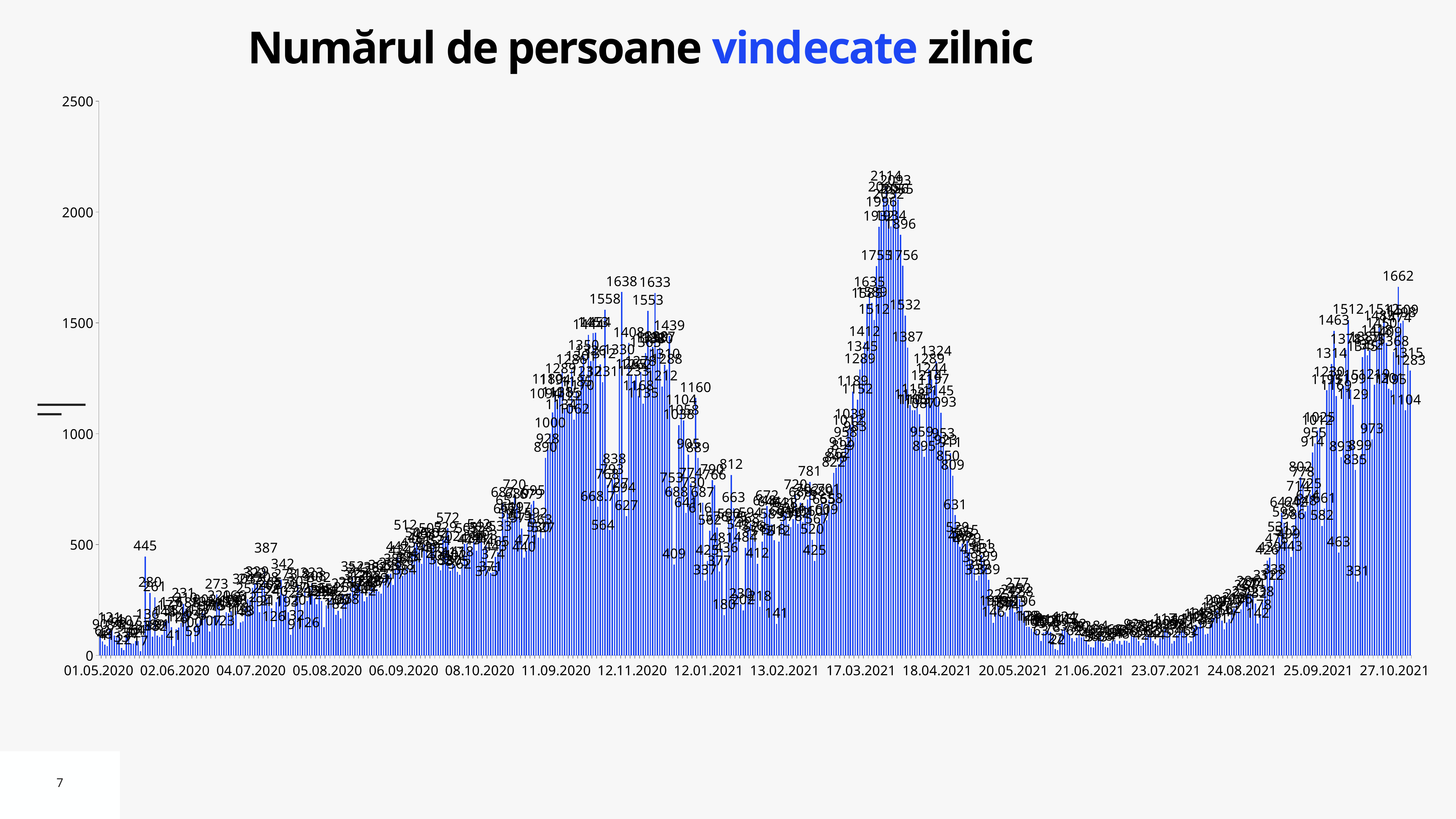
What is the title of the chart? Numărul de persoane vindecate zilnic What is the highest daily value labelled on the chart? 2114 Do the values rise or fall between 18.04.2021 and 21.06.2021? fall What is the difference between the overall peak value of 2114 and the late-October 2021 peak of 1662? 452 What kind of chart is shown on the slide? bar chart What is the value of the tallest bar in the peak near 12.11.2020? 1638 Do the values rise or fall between 24.08.2021 and 27.10.2021? rise What is the maximum value shown on the vertical axis? 2500 What is the value of the tallest bar in the peak near 27.10.2021? 1662 Is the highest bar on the chart greater or less than 2000? greater Is the tallest bar near 27.10.2021 greater or less than 1500? greater Which is larger, the peak value near 12.11.2020 (1638) or the peak value near 27.10.2021 (1662)? 1662